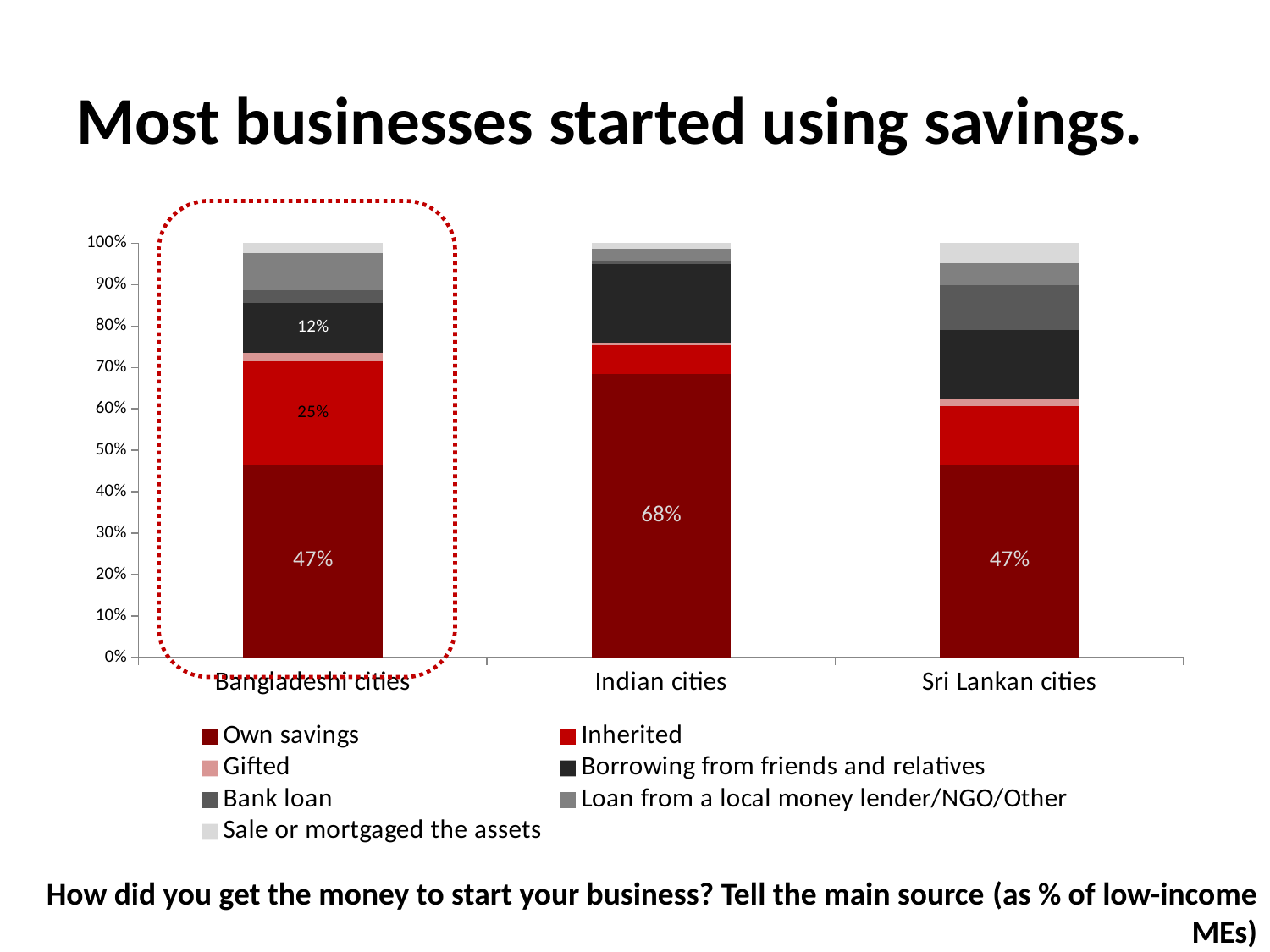
What is the Own savings value for Sri Lankan cities? 47% How many city groups are shown on the x axis? 3 Is the Borrowing from friends and relatives share for Indian cities greater or less than 10%? greater Which is larger: the Own savings share for Indian cities or for Bangladeshi cities? Indian cities How many series does the legend list? 7 What is the value of the Borrowing from friends and relatives segment for Bangladeshi cities? 12% How much higher is the Own savings share in Indian cities than in Bangladeshi cities? 21% Which city group has the highest share of businesses started with own savings? Indian cities What percentage of businesses in Indian cities started using own savings? 68% What kind of chart is shown on the slide? Stacked bar chart What is the value of the Inherited segment for Bangladeshi cities? 25% For Bangladeshi cities, what is the difference between the Inherited share and the Borrowing from friends and relatives share? 13%